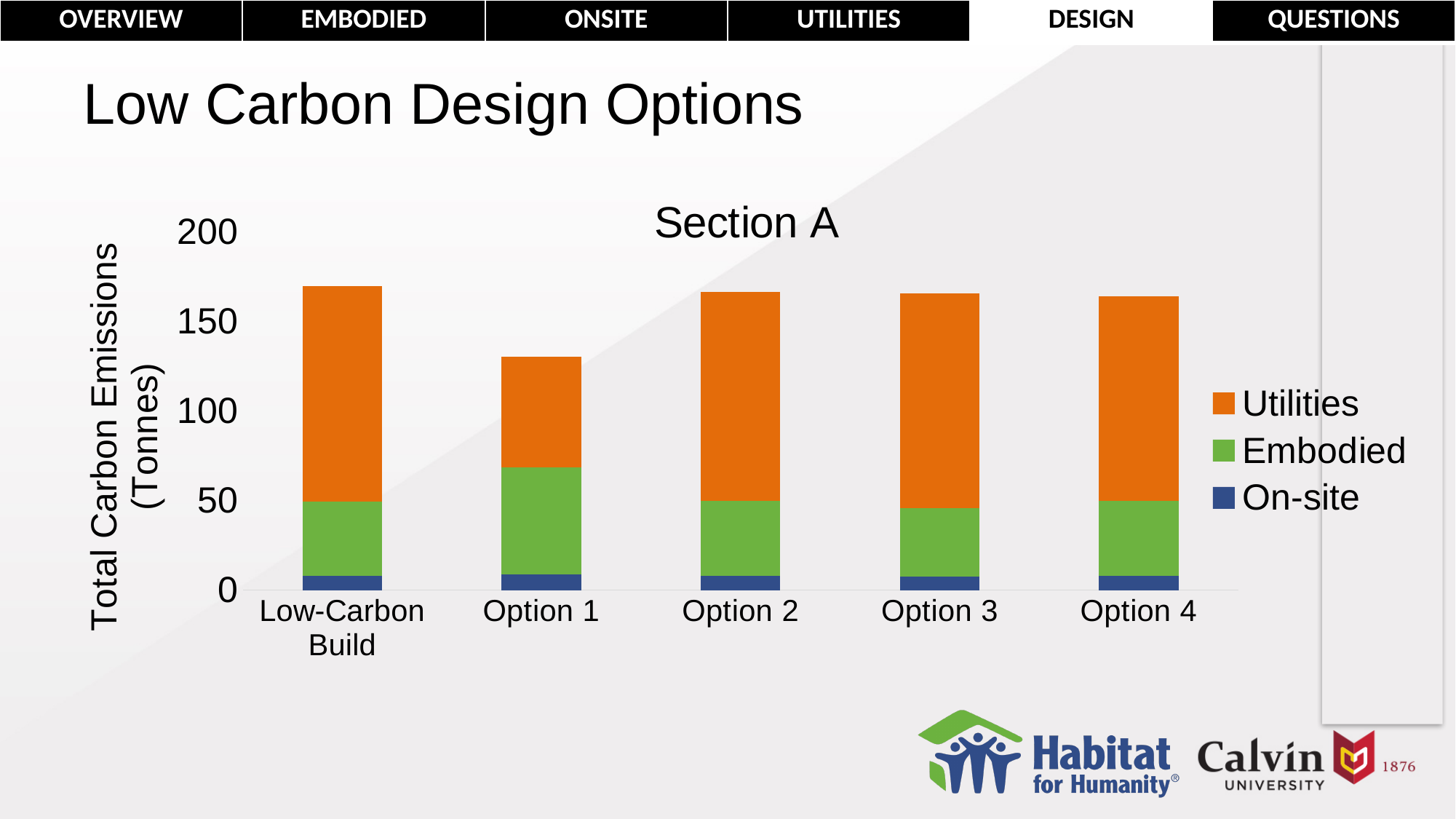
Which has the larger total carbon emissions, Option 1 or Option 2? Option 2 What kind of chart is shown on the slide? Stacked bar chart Is the total carbon emissions value for Option 1 greater or less than 150? less Which has the larger Embodied segment, Low-Carbon Build or Option 1? Option 1 Which category has the lowest total carbon emissions in the Section A chart? Option 1 What is the label on the y axis of the chart? Total Carbon Emissions (Tonnes) How many series does the legend of the Section A chart list? 3 Is the total carbon emissions value for Low-Carbon Build greater or less than 150? greater Is the total carbon emissions value for Option 1 greater or less than 100? greater How many design options (categories) are plotted along the x axis of the Section A chart? 5 Which has the larger Utilities segment, Low-Carbon Build or Option 1? Low-Carbon Build